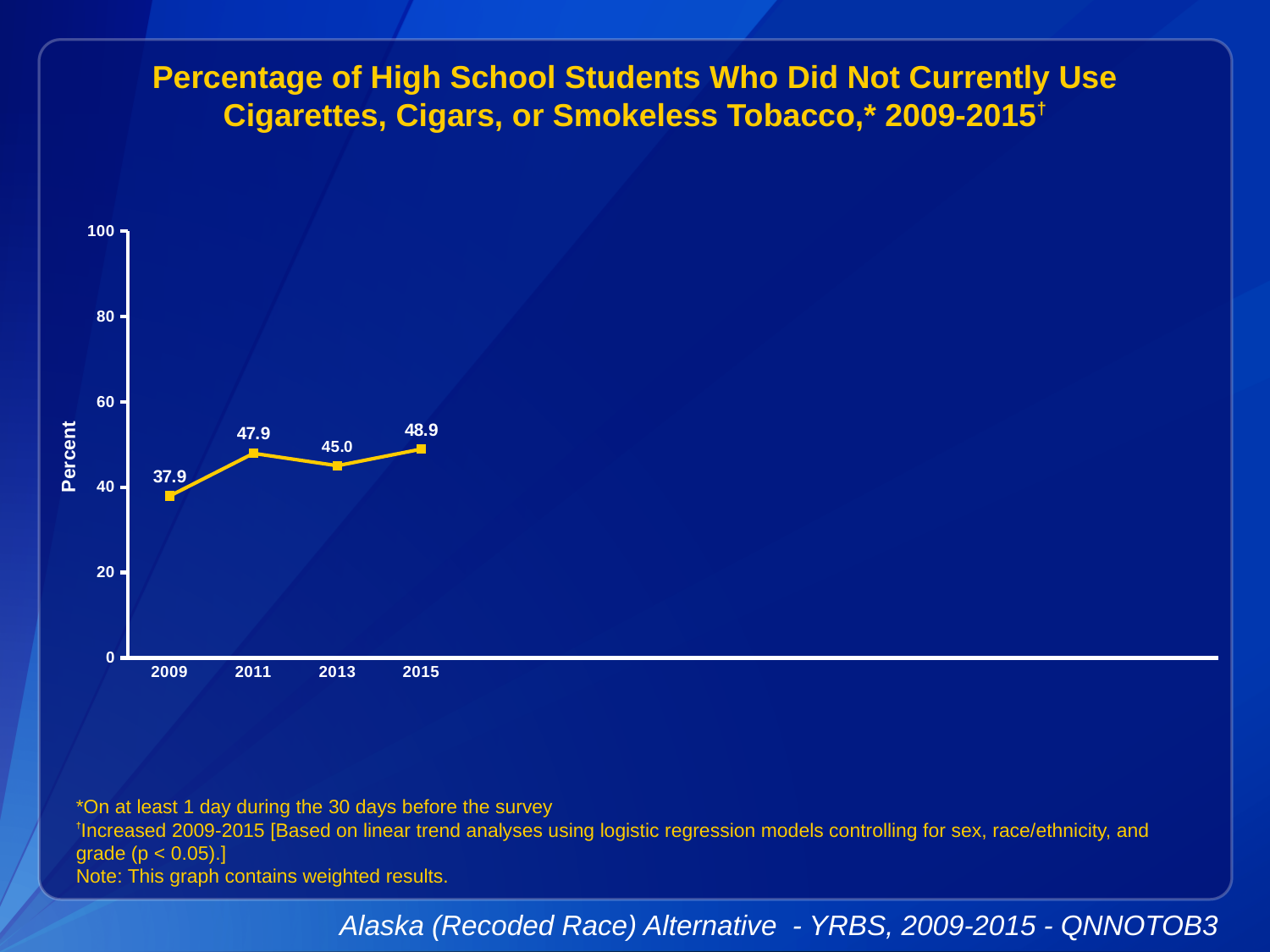
What is the value for 2009? 37.9 Is the value for 2009 greater or less than 40? less Which year has the highest value? 2015 Which year has the lowest value? 2009 What is the label of the y axis? Percent What is the value for 2015? 48.9 What kind of chart is shown on the slide? line chart What is the difference between the values for 2015 and 2009? 11.0 What is the value for 2011? 47.9 Which is larger, the value for 2011 or the value for 2013? 2011 How many data points are plotted on the chart? 4 What is the value for 2013? 45.0